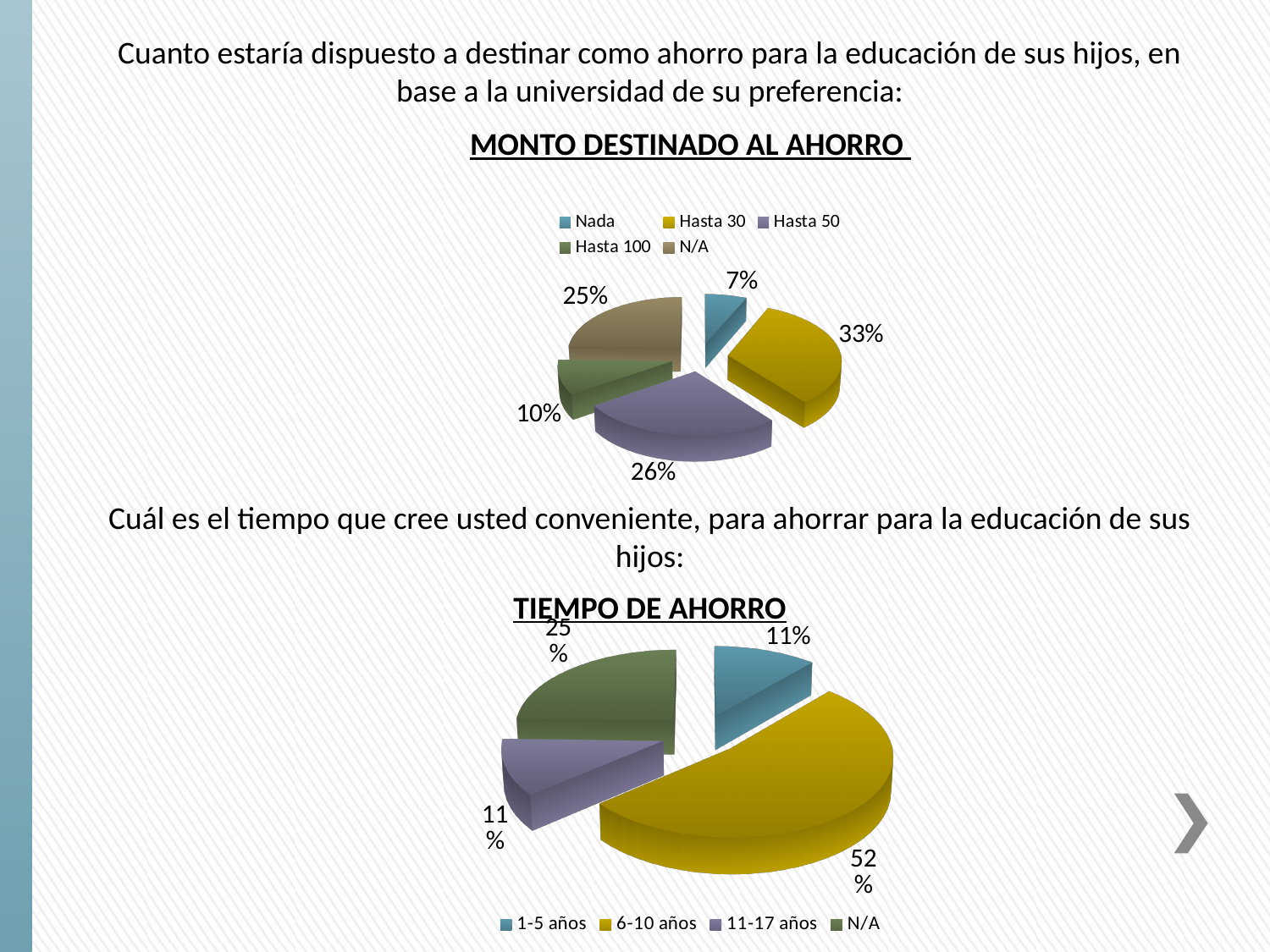
What type of chart is the MONTO DESTINADO AL AHORRO chart? Pie chart In the MONTO DESTINADO AL AHORRO chart, how many categories does the legend list? 5 In the TIEMPO DE AHORRO chart, what percentage is shown for 6-10 años? 52% In the TIEMPO DE AHORRO chart, is the share for 6-10 años larger or smaller than the share for N/A? Larger In the MONTO DESTINADO AL AHORRO chart, which category has the smallest share? Nada In the MONTO DESTINADO AL AHORRO chart, which category has the largest share? Hasta 30 In the MONTO DESTINADO AL AHORRO chart, what percentage is shown for Hasta 30? 33% In the TIEMPO DE AHORRO chart, how many categories does the legend list? 4 In the TIEMPO DE AHORRO chart, which category has the largest share? 6-10 años In the MONTO DESTINADO AL AHORRO chart, what percentage is shown for Nada? 7% In the MONTO DESTINADO AL AHORRO chart, what is the difference between the Hasta 50 share and the Hasta 100 share? 16% In the TIEMPO DE AHORRO chart, what percentage is shown for N/A? 25%